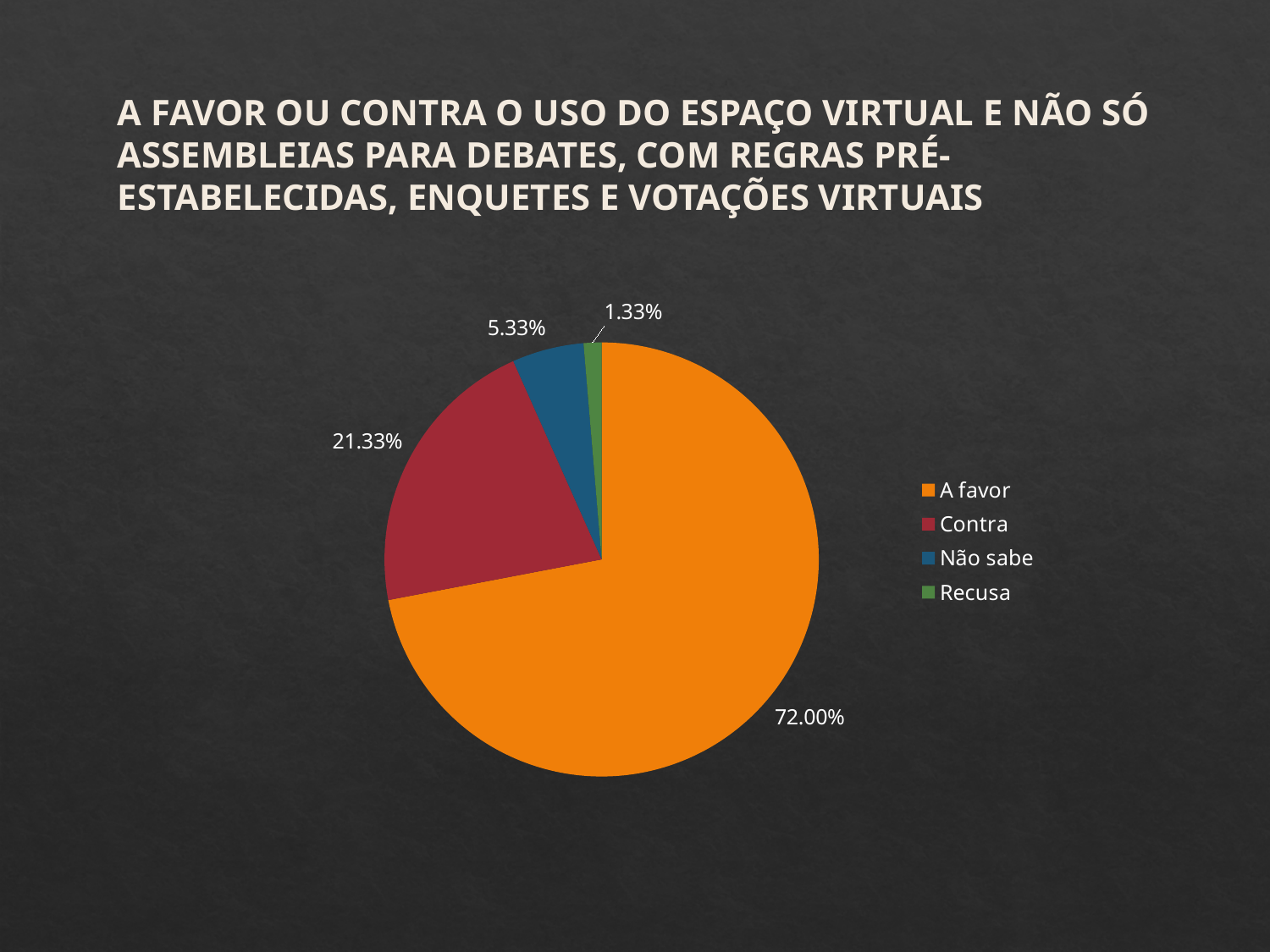
How many categories does the legend list? 4 What is the difference in percentage points between 'A favor' and 'Contra'? 50.67 What percentage of respondents are 'Contra'? 21.33% What is the combined share of 'Não sabe' and 'Recusa'? 6.66% What colour is the slice for 'Não sabe'? blue What kind of chart is shown on the slide? pie chart What percentage of respondents are 'A favor'? 72.00% Which is larger, the share for 'Contra' or the share for 'Não sabe'? Contra What percentage of respondents answered 'Não sabe'? 5.33% Which category has the largest share of the pie? A favor Which category has the smallest share of the pie? Recusa What percentage of respondents answered 'Recusa'? 1.33%